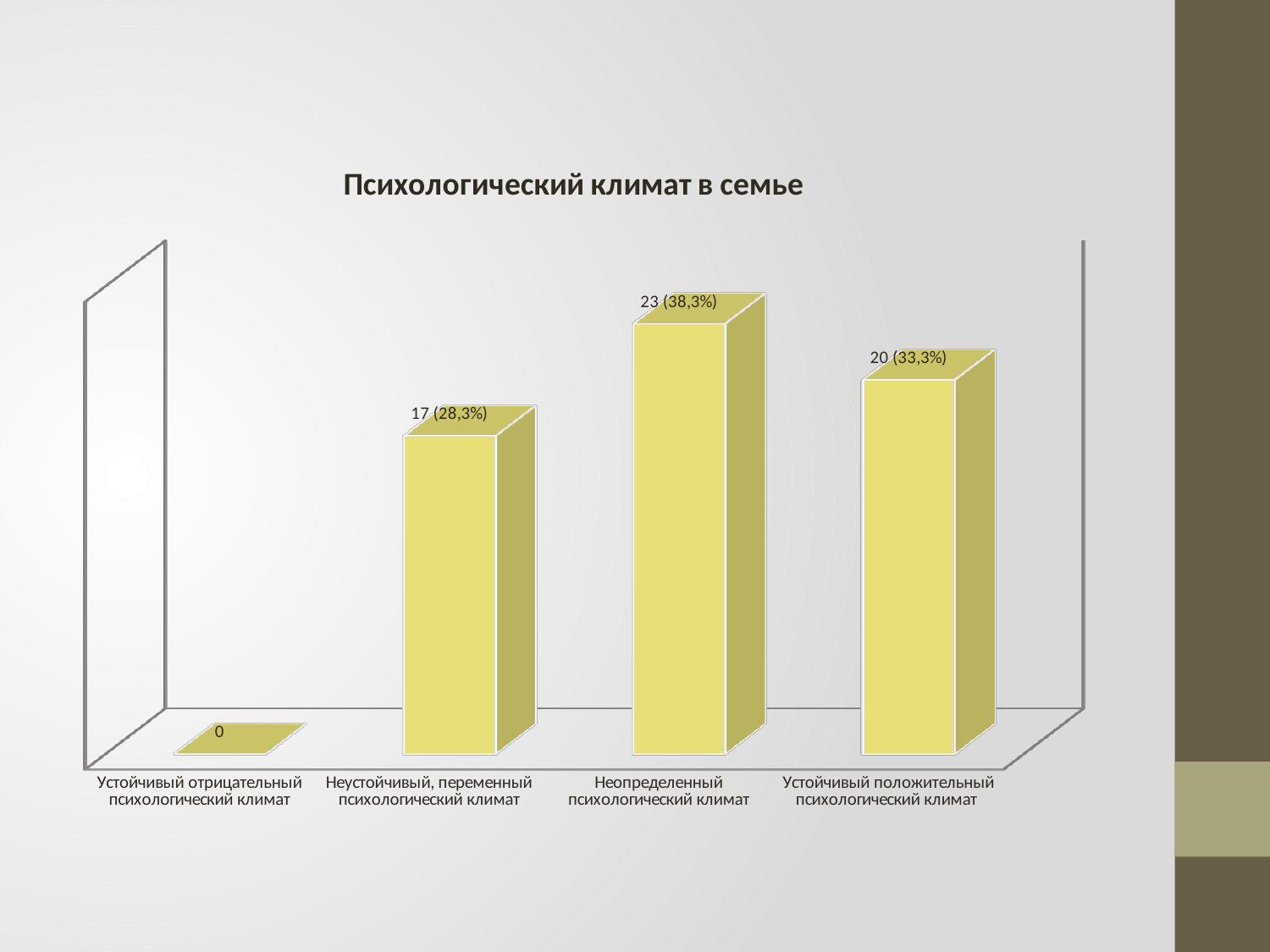
What is the data label for 'Неустойчивый, переменный психологический климат'? 17 (28,3%) What is the data label for 'Устойчивый положительный психологический климат'? 20 (33,3%) How many categories are shown in the chart? 4 What is the value for 'Устойчивый отрицательный психологический климат'? 0 What is the difference in count between 'Неопределенный психологический климат' and 'Устойчивый положительный психологический климат'? 3 What type of chart is shown on the slide? bar chart What is the data label for 'Неопределенный психологический климат'? 23 (38,3%) What is the difference in count between 'Неустойчивый, переменный психологический климат' and 'Устойчивый отрицательный психологический климат'? 17 Which category has the highest value? Неопределенный психологический климат Which is larger: the value for 'Неустойчивый, переменный психологический климат' or 'Устойчивый положительный психологический климат'? Устойчивый положительный психологический климат What is the title of the chart? Психологический климат в семье Which category has the lowest value? Устойчивый отрицательный психологический климат